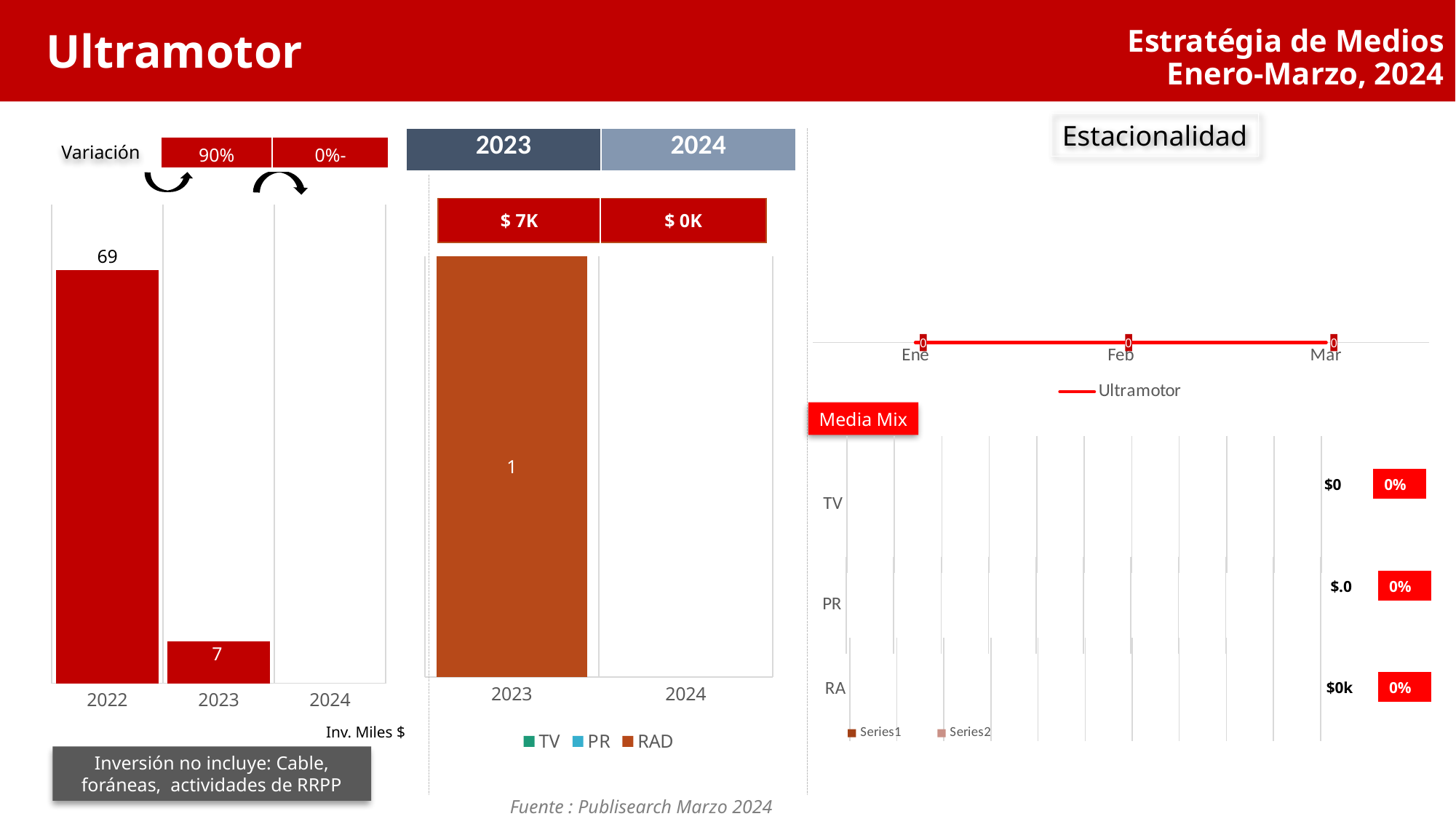
In the left bar chart, what is the value for 2022? 69 In the left bar chart, how many year categories are shown on the x axis? 3 What kind of chart is the left chart showing 2022, 2023 and 2024? bar chart In the Estacionalidad line chart, how many months are shown on the x axis? 3 In the Estacionalidad line chart, what is the value for Feb? 0 In the left bar chart, what is the value for 2023? 7 In the left bar chart, which is larger, the value for 2022 or the value for 2023? 2022 In the middle stacked bar chart, what value is labelled on the 2023 bar? 1 In the left bar chart, what is the difference between the 2022 and 2023 values? 62 In the middle stacked bar chart, how many series does the legend list? 3 In the left bar chart, which year has the highest value? 2022 In the Media Mix chart, what percentage is shown for TV? 0%